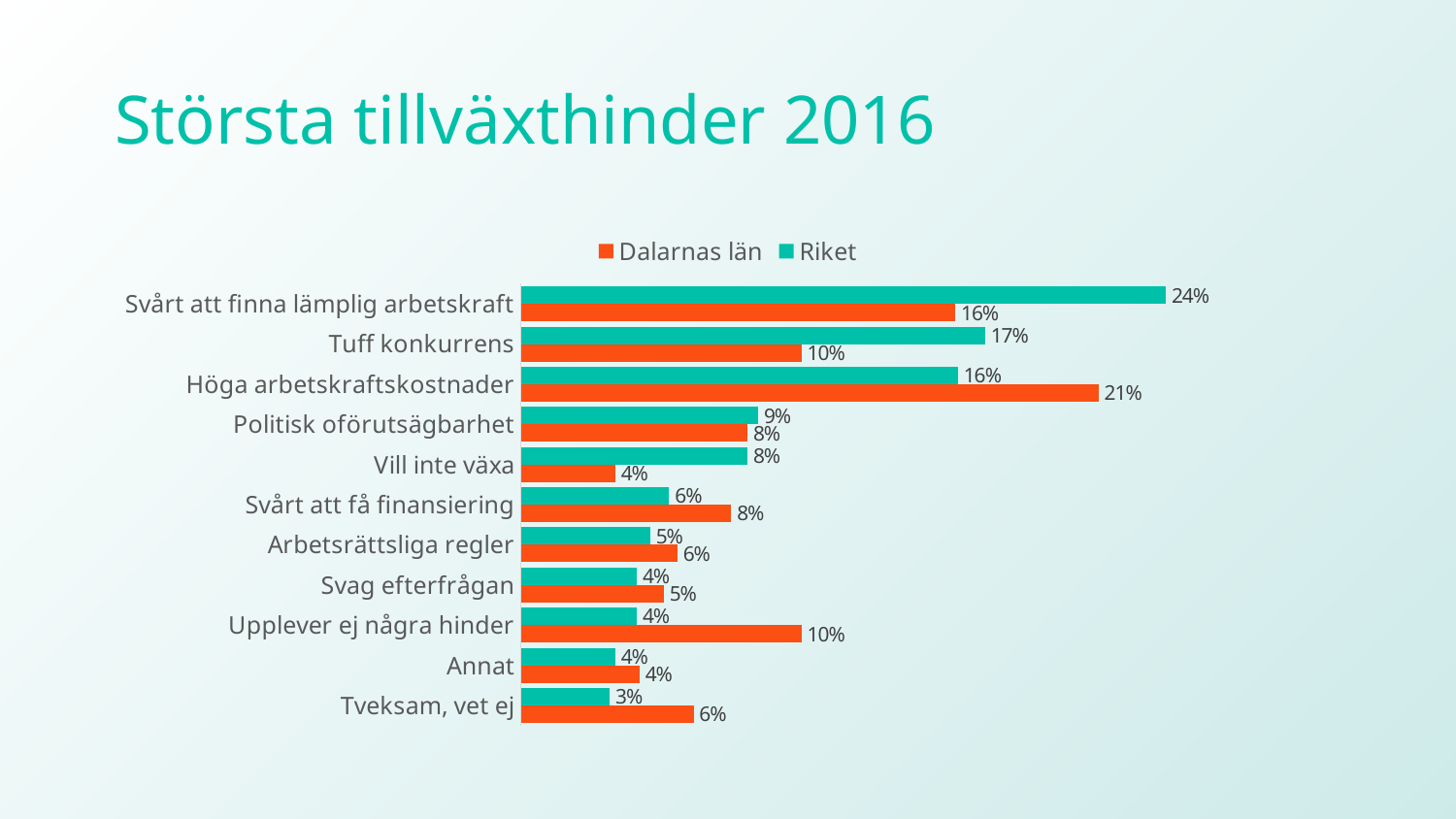
For Tuff konkurrens, which is larger: the Dalarnas län value or the Riket value? Riket Which category has the lowest Riket value? Tveksam, vet ej What is the Dalarnas län value for Höga arbetskraftskostnader? 21% What is the difference between the Riket and Dalarnas län values for Svårt att finna lämplig arbetskraft? 8% Which category has the highest Dalarnas län value? Höga arbetskraftskostnader What is the Dalarnas län value for Upplever ej några hinder? 10% What type of chart is shown on the slide? Bar chart What is the difference between the Dalarnas län and Riket values for Upplever ej några hinder? 6% What is the Riket value for Svårt att finna lämplig arbetskraft? 24% For Svårt att få finansiering, which is larger: the Dalarnas län value or the Riket value? Dalarnas län How many series does the legend list? 2 How many categories are shown in the chart? 11